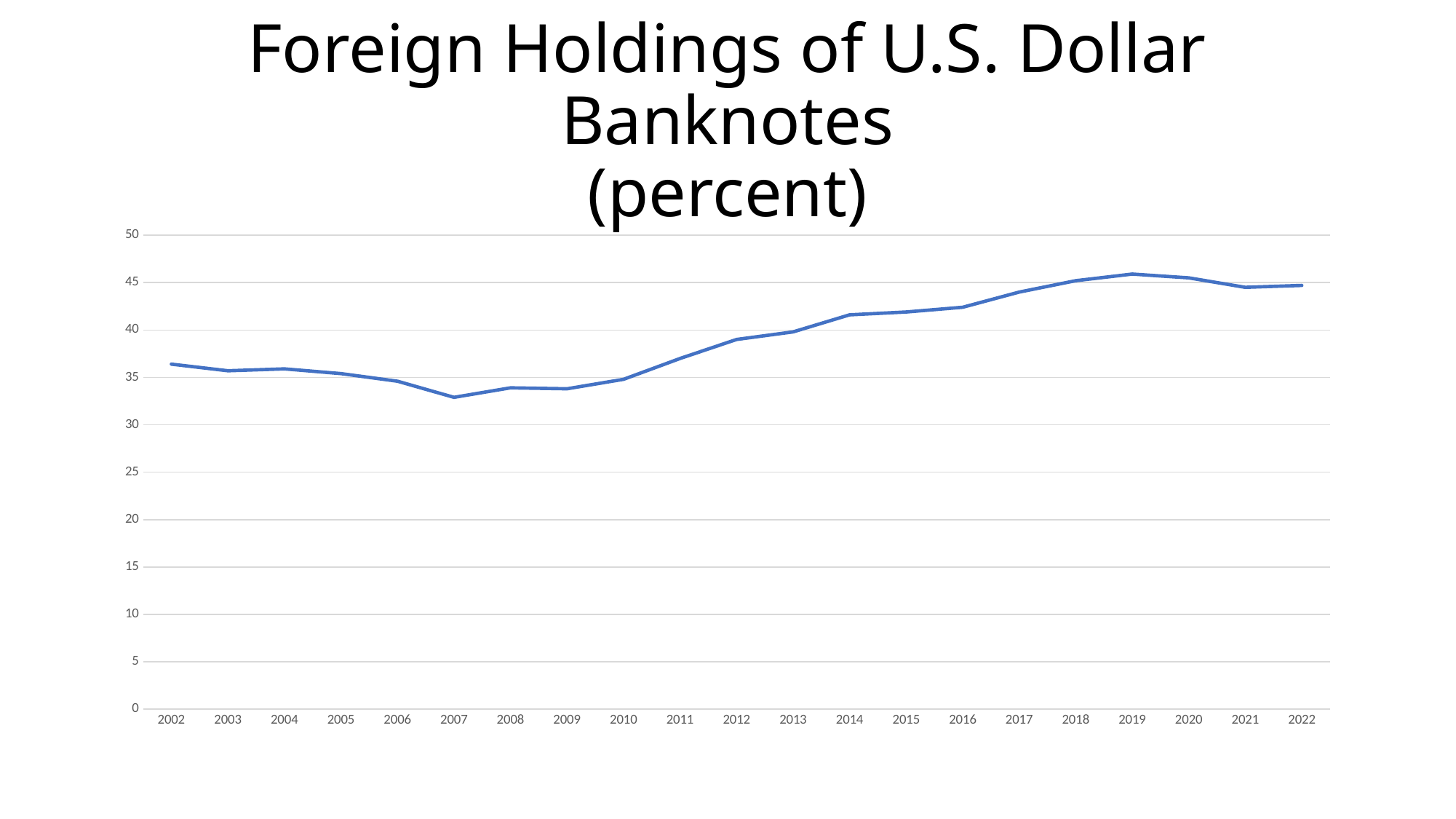
Which is larger, the value for 2002 or the value for 2007? 2002 Is the value for 2002 greater or less than 35? greater Is the value for 2014 greater or less than 40? greater What kind of chart is shown on the slide? line chart Is the value for 2007 greater or less than 35? less How many years are plotted along the x axis? 21 Which year has the lowest value? 2007 Which is larger, the value for 2009 or the value for 2014? 2014 Which year has the highest value? 2019 What is the title of the chart? Foreign Holdings of U.S. Dollar Banknotes (percent) Do the values rise or fall between 2007 and 2019? rise